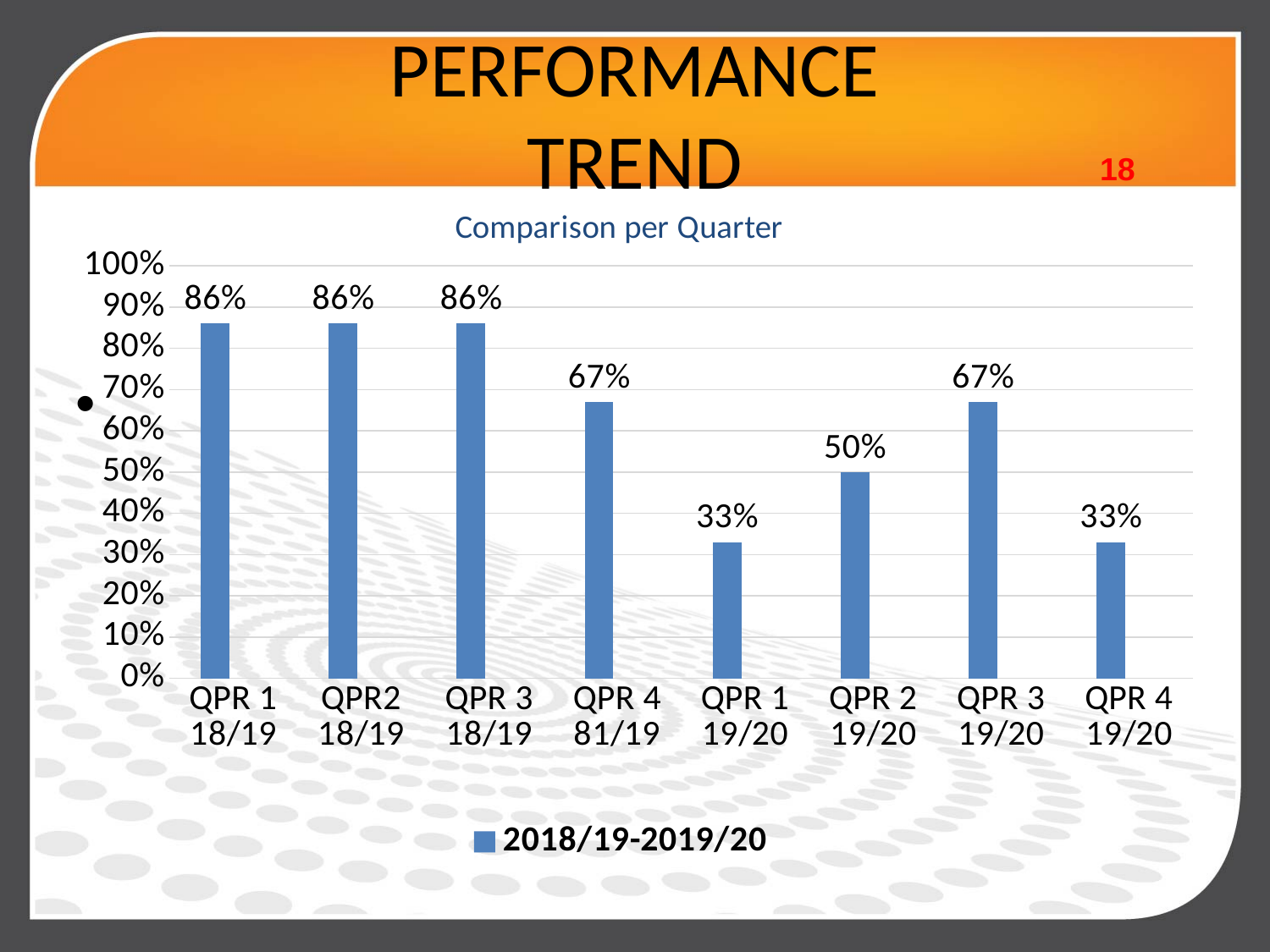
What is the value for QPR 4 19/20? 33% What is the value for QPR 2 19/20? 50% What is the difference between the values for QPR 3 18/19 and QPR 4 81/19? 19% What is the value for QPR 3 19/20? 67% Which category has the lowest value, QPR 1 19/20 or QPR 2 19/20? QPR 1 19/20 What is the value for QPR 1 18/19? 86% What kind of chart is shown on the slide? Bar chart How many categories are shown on the x axis? 8 What is the difference between the values for QPR 2 19/20 and QPR 4 19/20? 17% How many series does the legend list? 1 What is the title of the chart? Comparison per Quarter Is the value for QPR 3 19/20 larger than the value for QPR 2 19/20? Yes